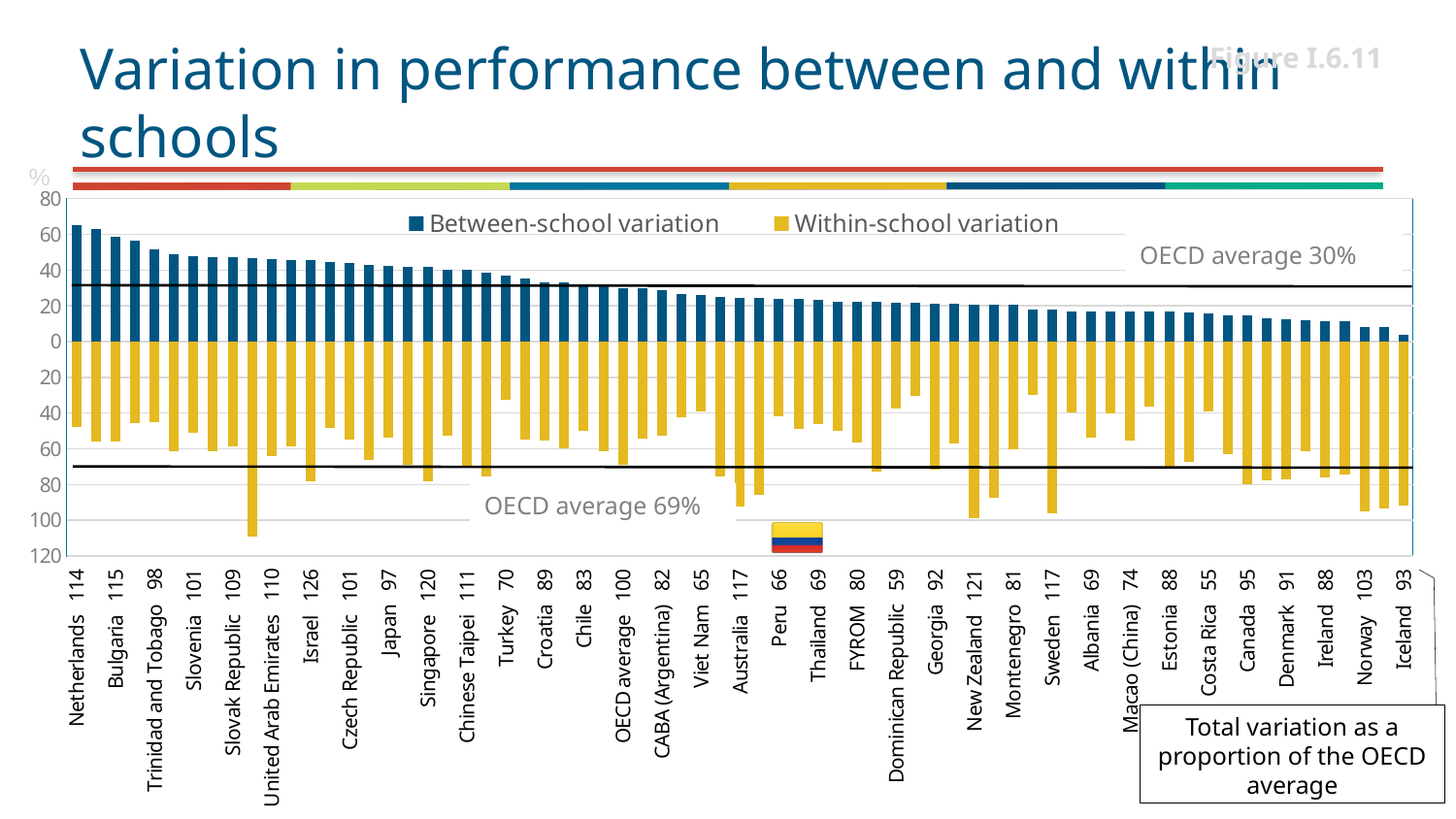
Is the between-school variation for the Netherlands greater or less than 60? greater What is the total variation as a proportion of the OECD average for the Netherlands? 114 What is the OECD average for between-school variation shown on the chart? 30% What is the difference between the total variation figures printed for Israel and Iceland? 33 Do the between-school variation bars rise or fall from left to right across the chart? fall Which labelled country has the highest total variation as a proportion of the OECD average? Israel How many series does the legend list? 2 What kind of chart is shown on the slide? bar chart What is the OECD average for within-school variation shown on the chart? 69% What are the two series named in the legend? Between-school variation and Within-school variation Which labelled country has the lowest total variation as a proportion of the OECD average? Costa Rica What is the total variation as a proportion of the OECD average for Israel? 126